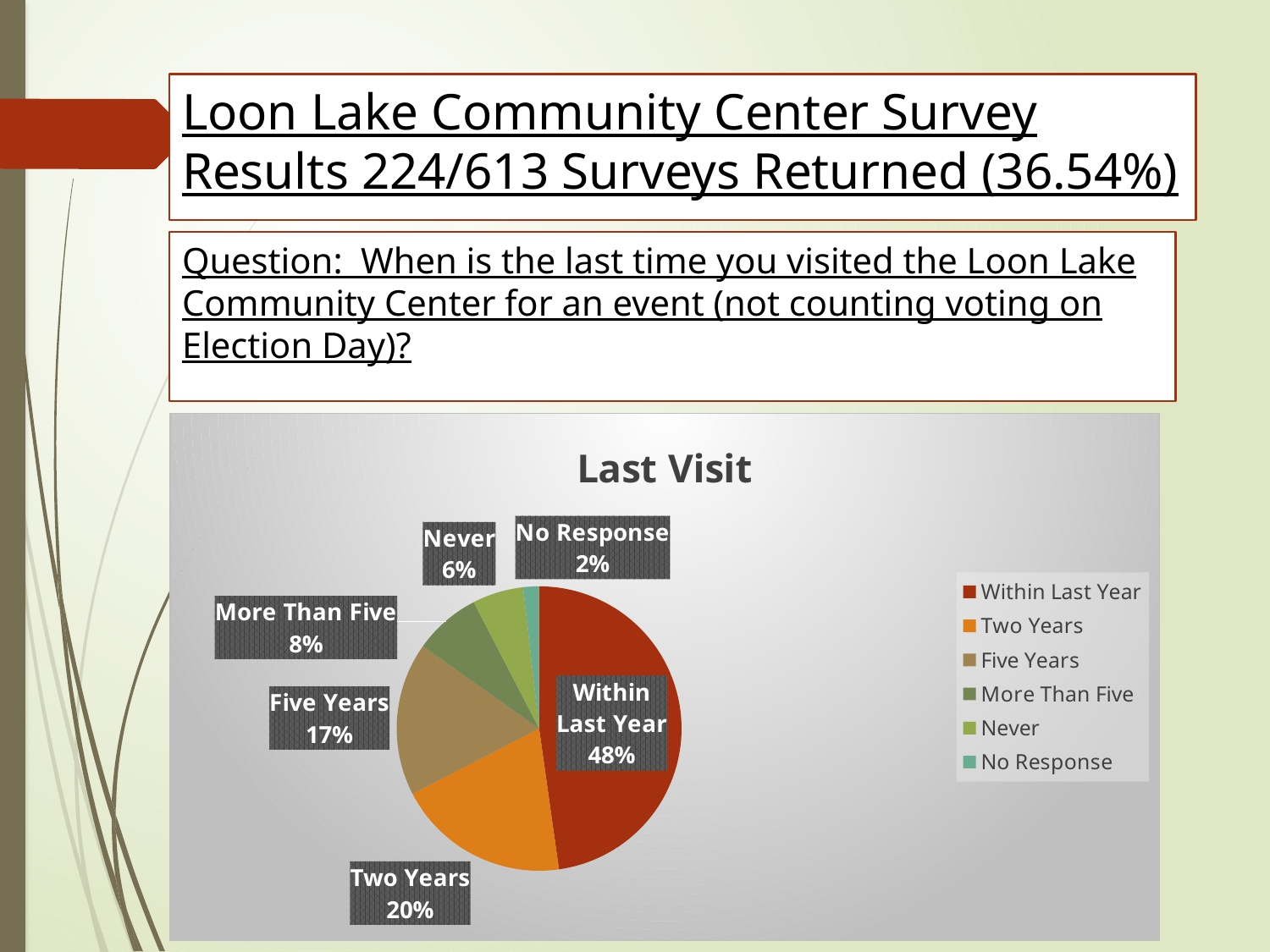
What percentage is shown for Two Years? 20% What is the title of the chart? Last Visit What share of the pie is labelled Within Last Year? 48% What kind of chart is shown on the slide? pie chart Which slice of the pie is the smallest? No Response Which slice of the pie is the largest? Within Last Year How many entries does the legend list? 6 How many slices does the pie chart have? 6 What percentage is shown for More Than Five? 8% What percentage is shown for Five Years? 17% What is the difference in percentage points between Within Last Year and Two Years? 28 What percentage is shown for Never? 6%